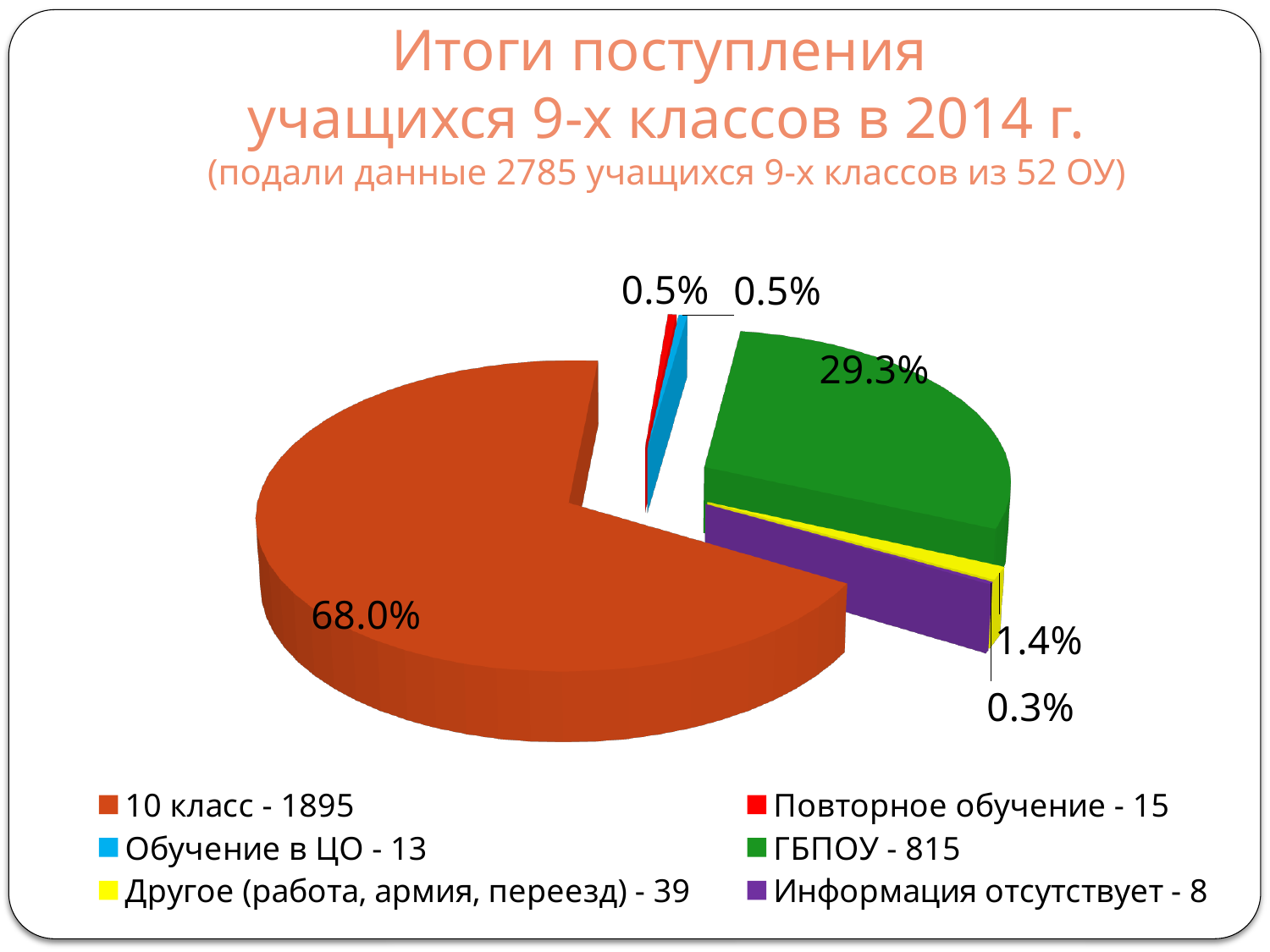
According to the legend, how many students are in the "Повторное обучение" category? 15 How many categories does the pie chart have? 6 What percentage is shown for the "ГБПОУ - 815" slice? 29.3% What is the difference in percentage points between the "10 класс" slice and the "ГБПОУ" slice? 38.7 Which slice is larger: "ГБПОУ - 815" or "Другое (работа, армия, переезд) - 39"? ГБПОУ - 815 What percentage is shown for the "Информация отсутствует - 8" slice? 0.3% What share of the pie does the "10 класс - 1895" slice represent? 68.0% Which category has the smallest slice of the pie? Информация отсутствует - 8 What kind of chart is shown on the slide? pie chart Which category has the largest slice of the pie? 10 класс - 1895 What percentage is shown for the "Другое (работа, армия, переезд) - 39" slice? 1.4% What colour is the "ГБПОУ - 815" slice in the pie chart? green